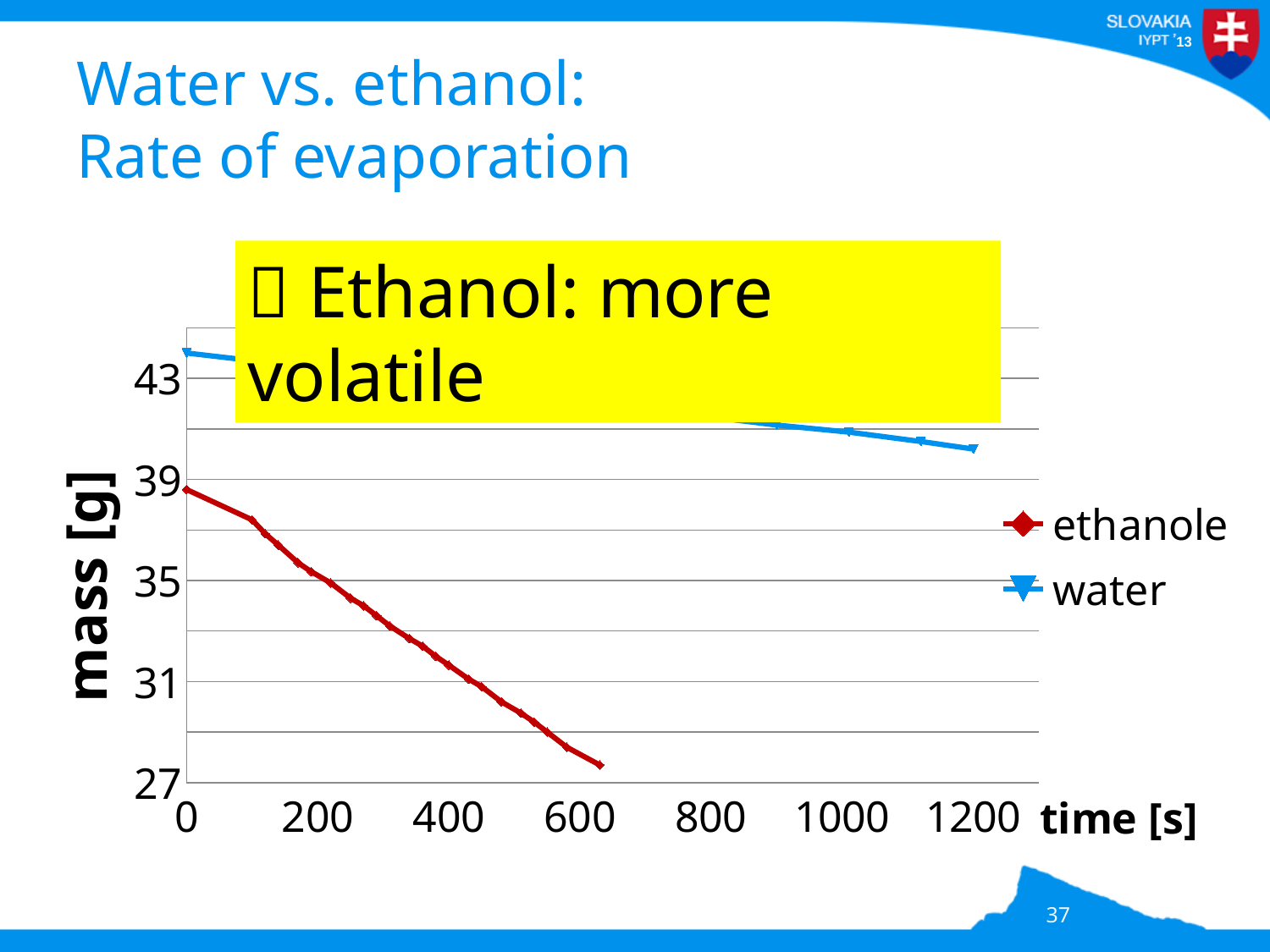
Is the mass of ethanole at 400 s greater or less than 35 g? less Is the mass of ethanole at time 0 greater or less than 35 g? greater Is the mass of ethanole at 600 s greater or less than 31 g? less Does the mass of water rise or fall as time increases? fall Which series loses mass faster over time: ethanole or water? ethanole What kind of chart is shown on the slide? line chart What are the two series named in the legend? ethanole and water Which series has the higher mass at time 0: ethanole or water? water How many series does the legend list? 2 What is the label of the y axis? mass [g] Does the mass of ethanole rise or fall as time increases? fall